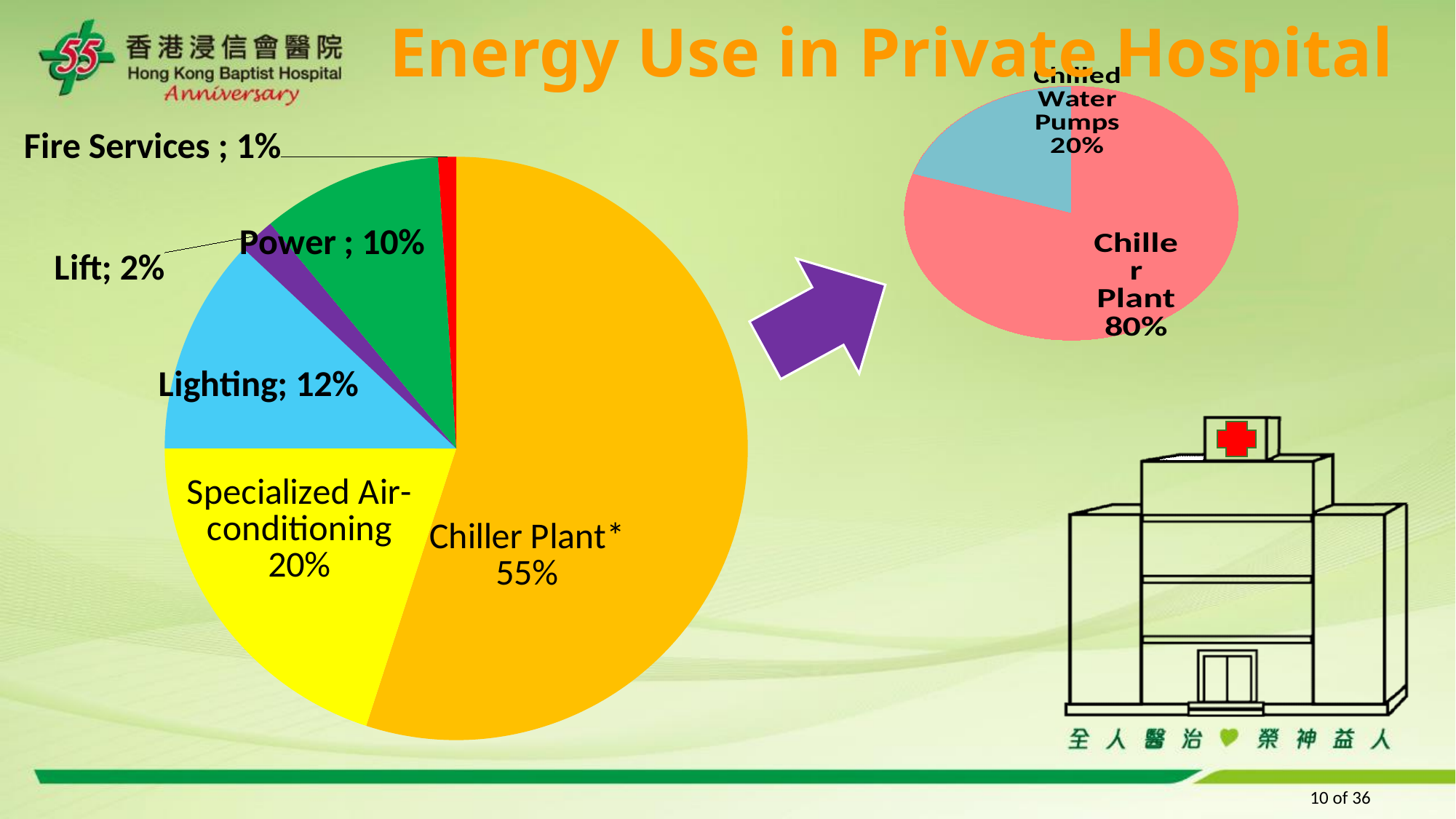
In the small pie chart on the right, what percentage is shown for Chilled Water Pumps? 20% In the large pie chart on the left, what percentage is shown for Lighting? 12% In the large pie chart on the left, which category has the smallest share? Fire Services What type of chart is the large chart on the left? Pie chart In the large pie chart on the left, what percentage is shown for Specialized Air-conditioning? 20% In the small pie chart on the right, what percentage is shown for Chiller Plant? 80% In the large pie chart on the left, which category has the largest share? Chiller Plant* How many categories are shown in the large pie chart on the left? 6 In the large pie chart on the left, what share of energy use is attributed to Chiller Plant*? 55% In the large pie chart on the left, which is larger, the share for Lift or the share for Fire Services? Lift How many slices does the small pie chart on the right have? 2 In the large pie chart on the left, what is the difference between the Lighting share and the Power share? 2%